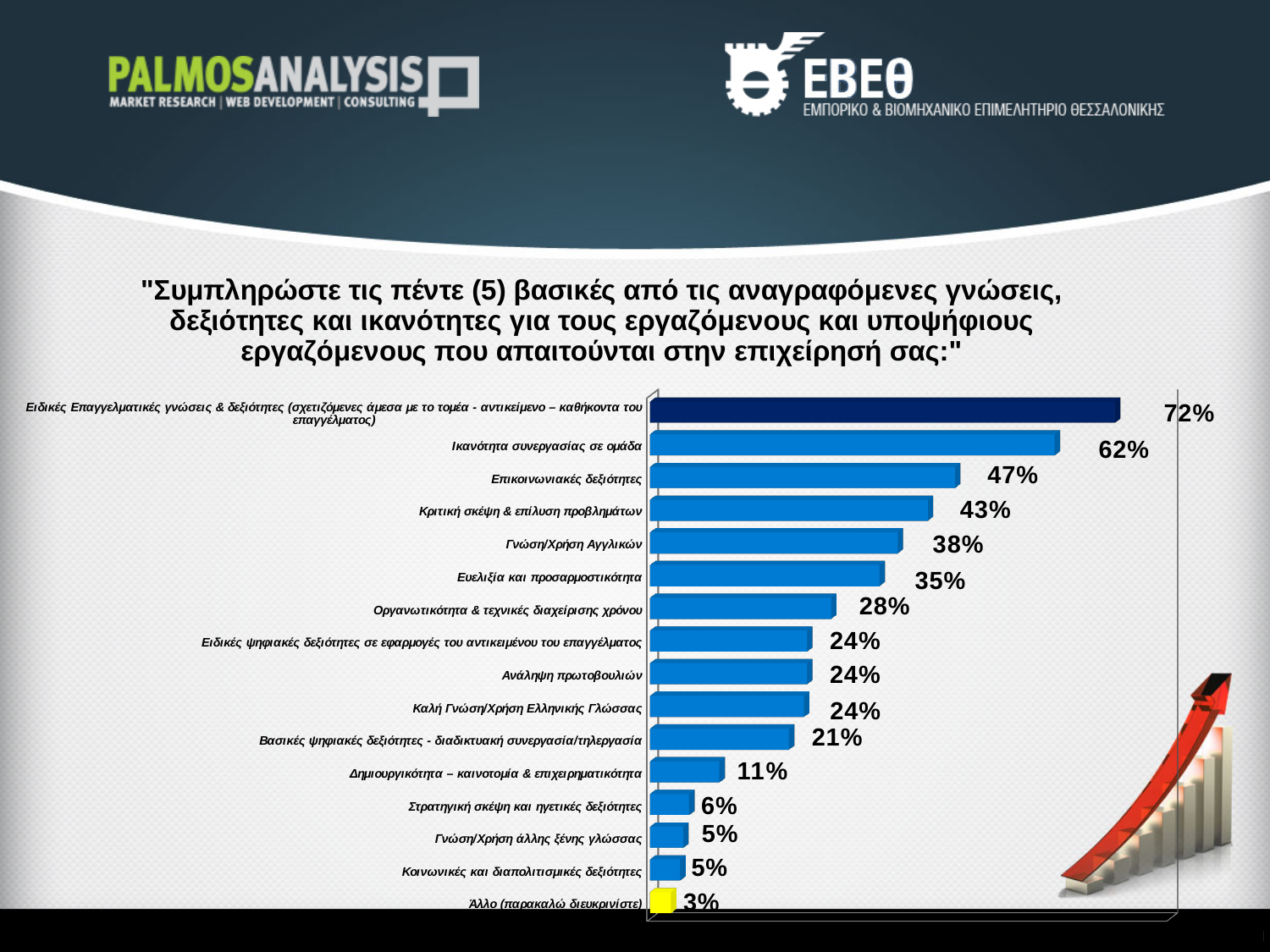
Which is larger: the value for "Ευελιξία και προσαρμοστικότητα" or the value for "Οργανωτικότητα & τεχνικές διαχείρισης χρόνου"? Ευελιξία και προσαρμοστικότητα Which bar is coloured yellow instead of blue? Άλλο (παρακαλώ διευκρινίστε) What is the value for "Γνώση/Χρήση Αγγλικών"? 38% How many categories are shown in the chart? 16 What is the value for "Βασικές ψηφιακές δεξιότητες - διαδικτυακή συνεργασία/τηλεργασία"? 21% What is the value for "Δημιουργικότητα – καινοτομία & επιχειρηματικότητα"? 11% What is the value for "Ικανότητα συνεργασίας σε ομάδα"? 62% Which category has the lowest value? Άλλο (παρακαλώ διευκρινίστε) What is the difference between the values for "Επικοινωνιακές δεξιότητες" and "Κριτική σκέψη & επίλυση προβλημάτων"? 4% What kind of chart is shown on the slide? Bar chart What is the difference between the highest value (72%) and the value for "Ικανότητα συνεργασίας σε ομάδα"? 10% Which category has the highest value? Ειδικές Επαγγελματικές γνώσεις & δεξιότητες